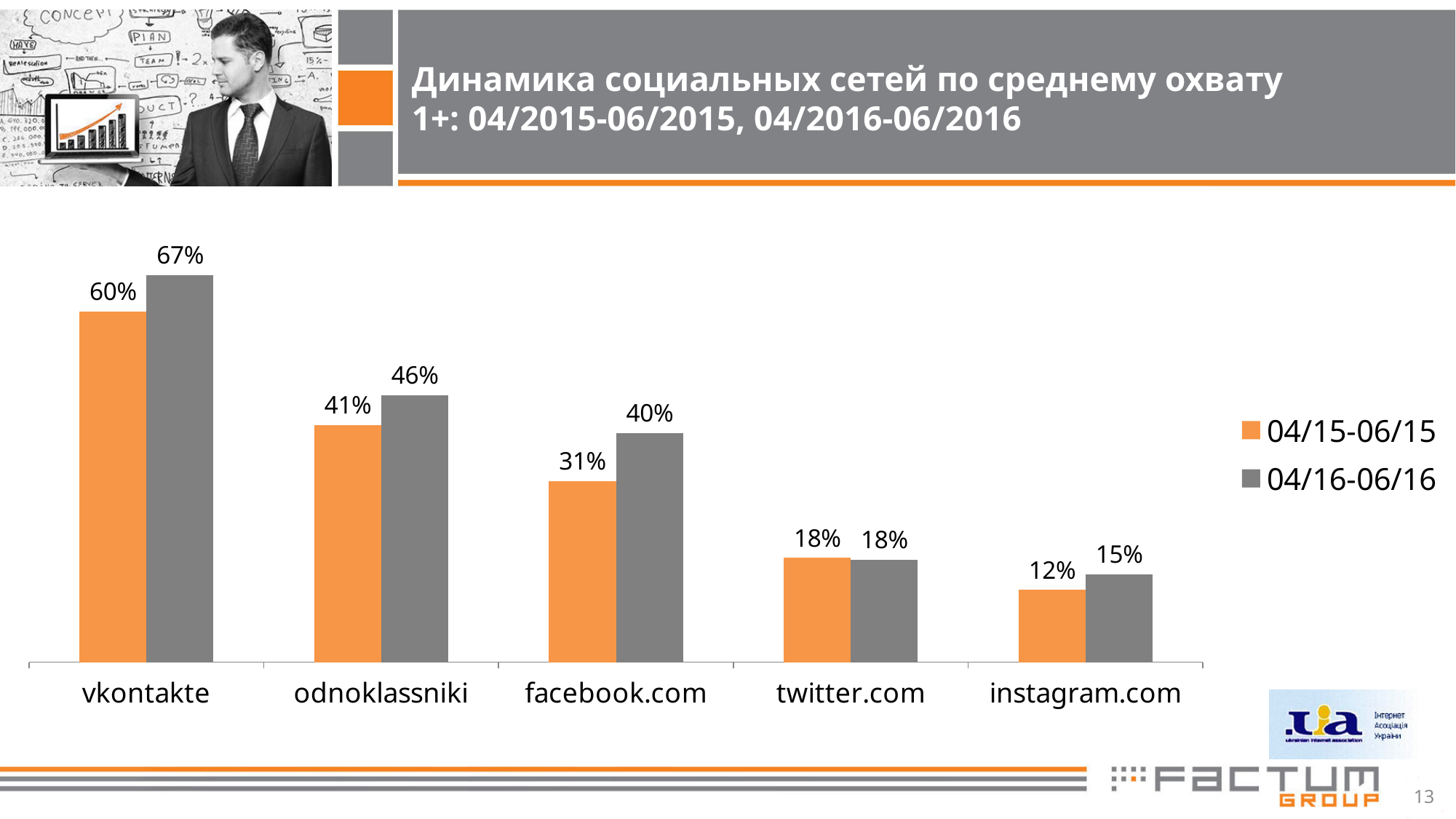
How many series does the legend list? 2 What kind of chart is shown on the slide? bar chart What is the value for instagram.com in the 04/16-06/16 series? 15% What is the value for vkontakte in the 04/16-06/16 series? 67% Which colour represents the 04/15-06/15 series? orange What is the value for facebook.com in the 04/15-06/15 series? 31% What is the difference between the 04/16-06/16 and 04/15-06/15 values for facebook.com? 9% Which is larger: the 04/15-06/15 value for odnoklassniki or the 04/16-06/16 value for facebook.com? odnoklassniki 04/15-06/15 Which category has the lowest value in the 04/16-06/16 series? instagram.com How many social networks are shown on the x axis? 5 Which category has the highest value in the 04/15-06/15 series? vkontakte What is the difference between the 04/16-06/16 and 04/15-06/15 values for vkontakte? 7%